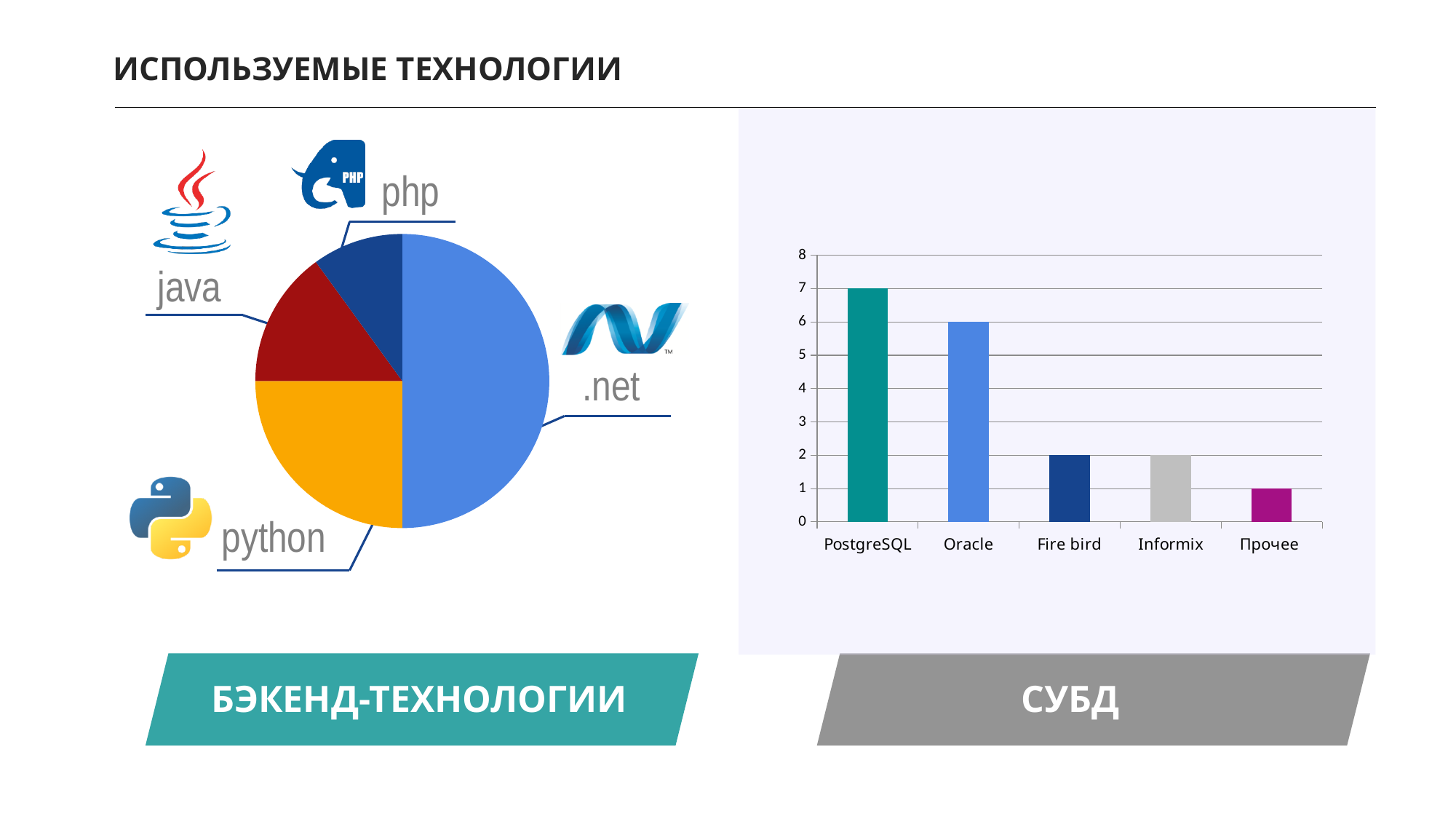
In the bar chart on the right (СУБД), which category has the highest value? PostgreSQL In the bar chart on the right (СУБД), what is the value for PostgreSQL? 7 How many slices does the pie chart on the left have? 4 In the bar chart on the right (СУБД), what is the value for Прочее? 1 In the bar chart on the right (СУБД), what is the difference between the values for PostgreSQL and Fire bird? 5 In the pie chart on the left, which slice is larger, python or java? python In the pie chart on the left, which technology has the largest slice? .net What kind of chart is shown on the left side of the slide under "БЭКЕНД-ТЕХНОЛОГИИ"? pie chart In the bar chart on the right (СУБД), what is the value for Oracle? 6 In the pie chart on the left, which technology has the smallest slice? php How many categories are shown in the bar chart on the right (СУБД)? 5 What kind of chart is shown on the right side of the slide under "СУБД"? bar chart